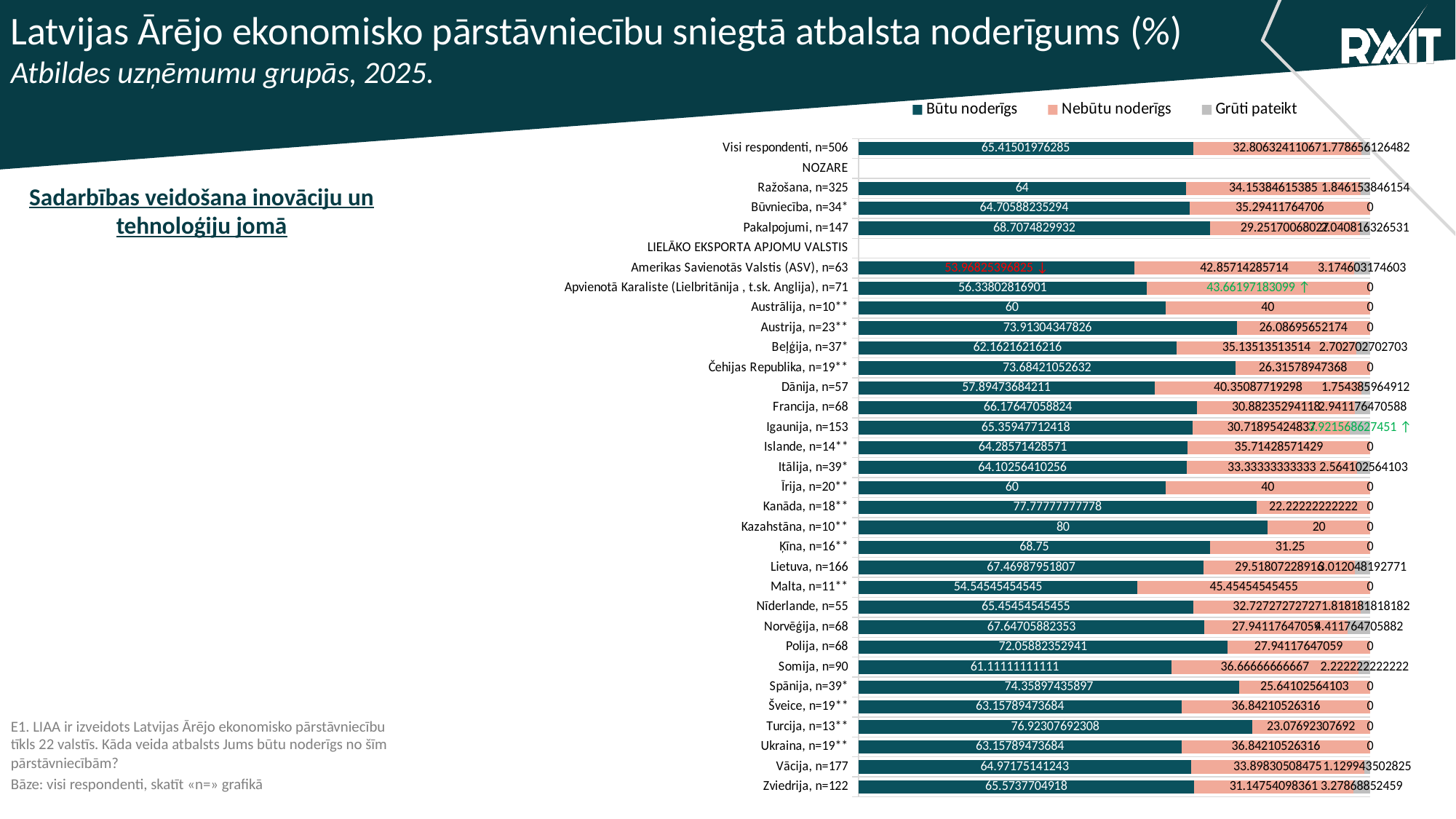
What are the three legend entries of the chart? Būtu noderīgs, Nebūtu noderīgs, Grūti pateikt What is the 'Nebūtu noderīgs' value for Austrālija, n=10**? 40 What is the 'Būtu noderīgs' value for Kazahstāna, n=10**? 80 Which group has the highest 'Būtu noderīgs' value? Kazahstāna, n=10** How many series does the legend list? 3 What is the total of the stacked bar for Kazahstāna, n=10**? 100 What is the 'Būtu noderīgs' value for Ražošana, n=325? 64 What is the 'Būtu noderīgs' value for Ķīna, n=16**? 68.75 Which has the larger 'Būtu noderīgs' value, Kanāda, n=18** or Polija, n=68? Kanāda, n=18** What kind of chart is shown on the slide? Stacked horizontal bar chart What is the difference between the 'Būtu noderīgs' values for Kazahstāna, n=10** and Īrija, n=20**? 20 Which group has the lowest 'Būtu noderīgs' value? Amerikas Savienotās Valstis (ASV), n=63